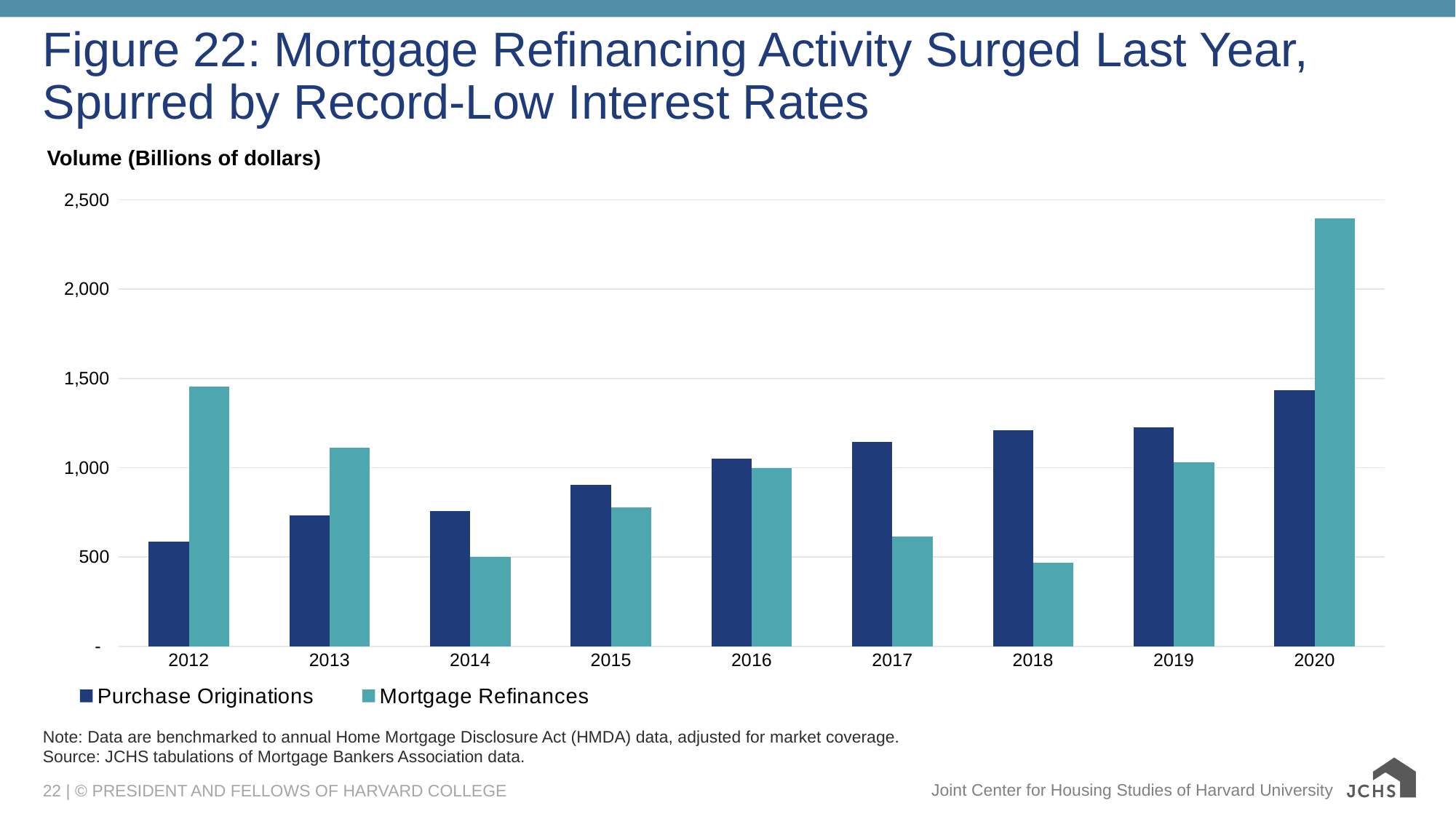
Is the Purchase Originations value for 2018 greater or less than 1,000? greater How many series does the legend list? 2 How many years are shown on the x axis? 9 In 2012, which is larger: Purchase Originations or Mortgage Refinances? Mortgage Refinances In which year is the Purchase Originations value highest? 2020 Do the Purchase Originations values rise or fall from 2012 to 2020? Rise In which year is the Purchase Originations value lowest? 2012 What kind of chart is shown on the slide? Bar chart In 2018, which is larger: Purchase Originations or Mortgage Refinances? Purchase Originations In which year is the Mortgage Refinances value highest? 2020 Is the Mortgage Refinances value for 2014 greater or less than 1,000? less Is the Mortgage Refinances value for 2020 greater or less than 2,000? greater